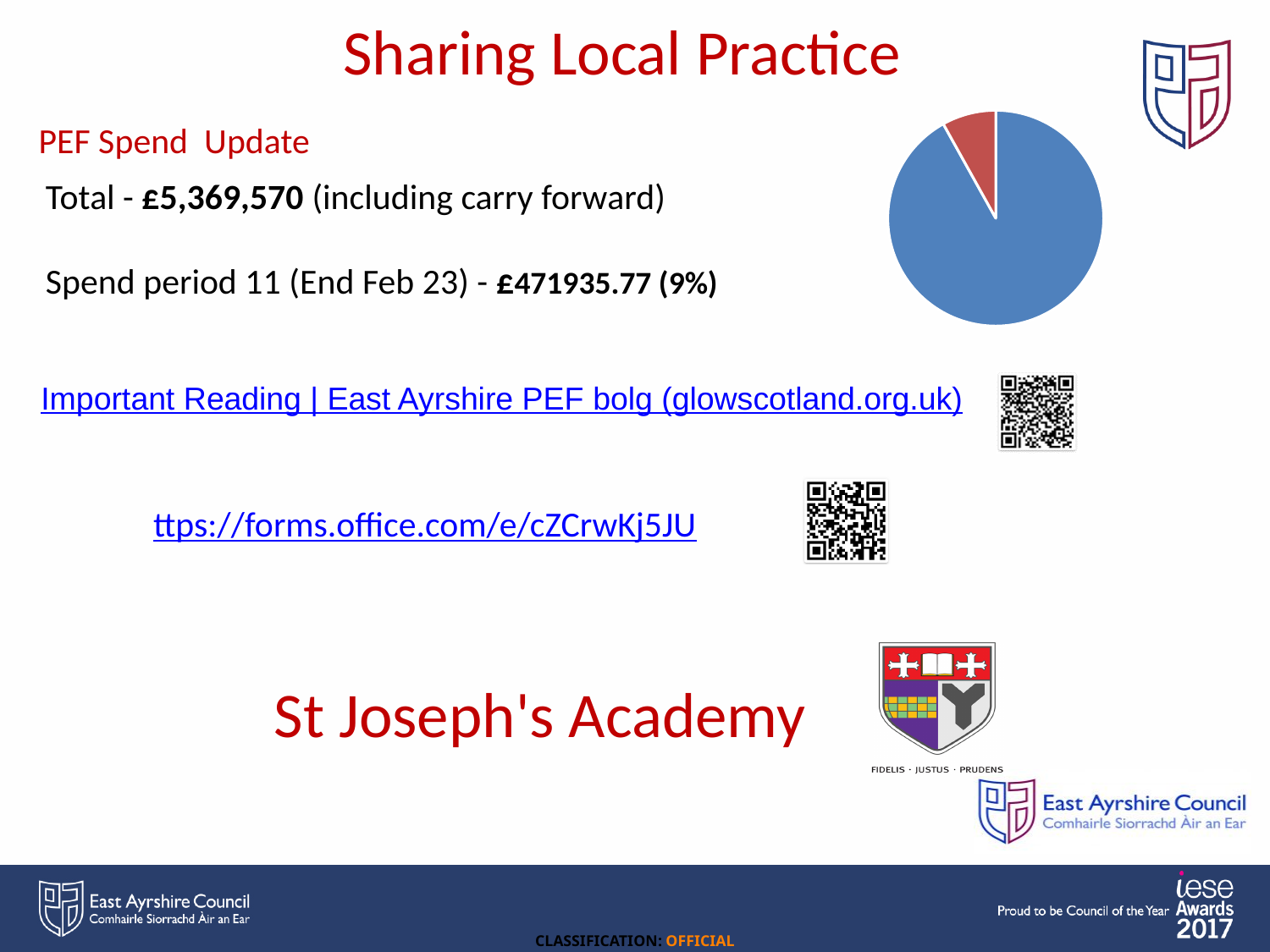
Which colour slice of the pie chart is the largest? blue Is the red slice of the pie chart greater or less than half of the pie? less Which colour slice of the pie chart is the smallest? red How many slices does the pie chart have? 2 What kind of chart is shown on the slide? pie chart Which slice of the pie chart is larger, the blue slice or the red slice? blue What two colours are used for the slices of the pie chart? blue and red Does the pie chart display a legend? No Is the blue slice of the pie chart greater or less than 75% of the pie? greater